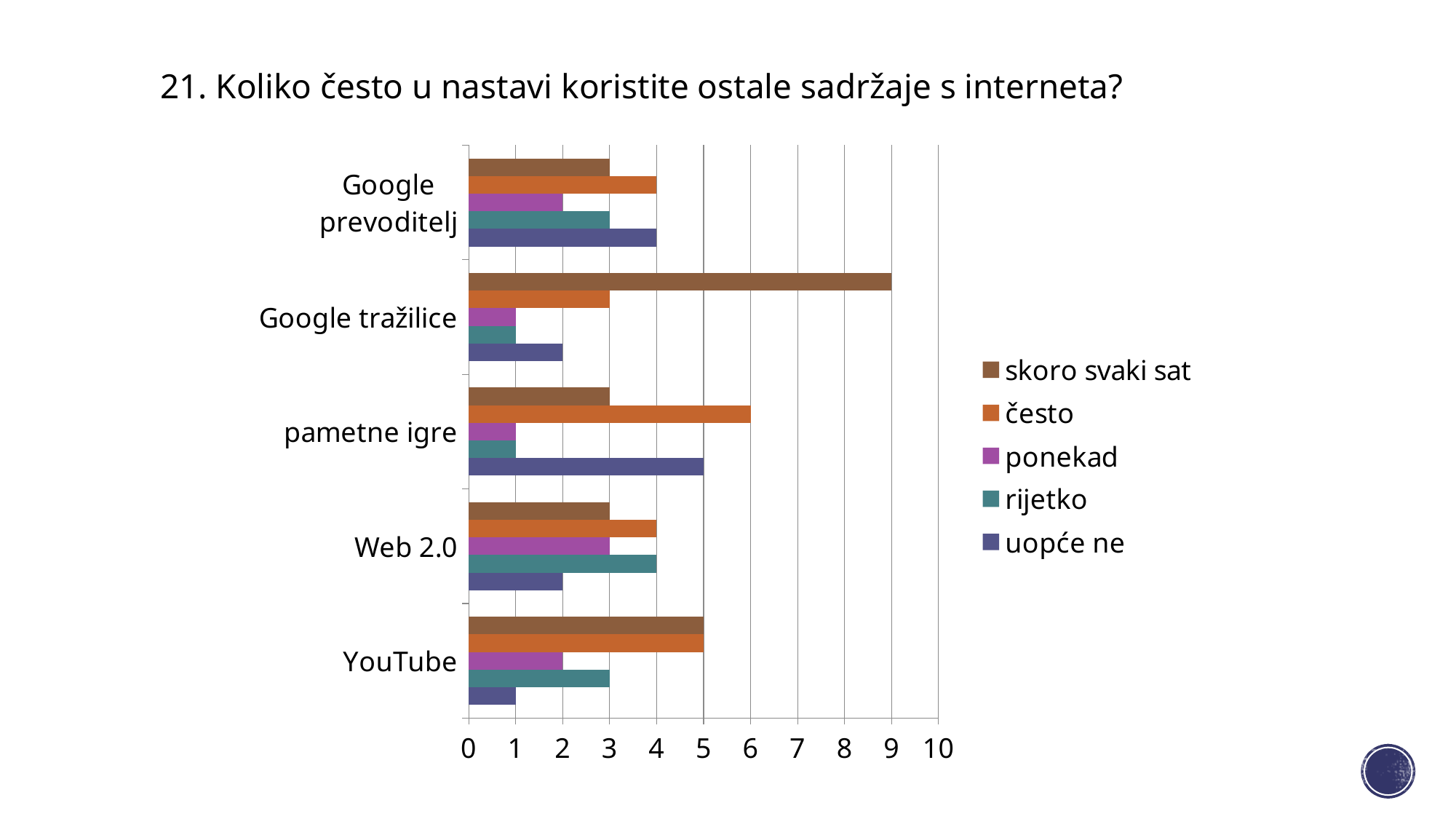
Which category has the lowest value for 'uopće ne'? YouTube What is the title of the chart? 21. Koliko često u nastavi koristite ostale sadržaje s interneta? What is the difference between the 'skoro svaki sat' value for Google tražilice and for YouTube? 4 What is the value of 'rijetko' for Web 2.0? 4 What is the value of 'često' for pametne igre? 6 How many series does the legend list? 5 Which category has the highest value for 'skoro svaki sat'? Google tražilice What is the value of 'uopće ne' for YouTube? 1 What is the value of 'skoro svaki sat' for Google tražilice? 9 What kind of chart is shown on the slide? bar chart Which is larger for pametne igre: the 'često' value or the 'uopće ne' value? često How many categories are shown on the chart? 5